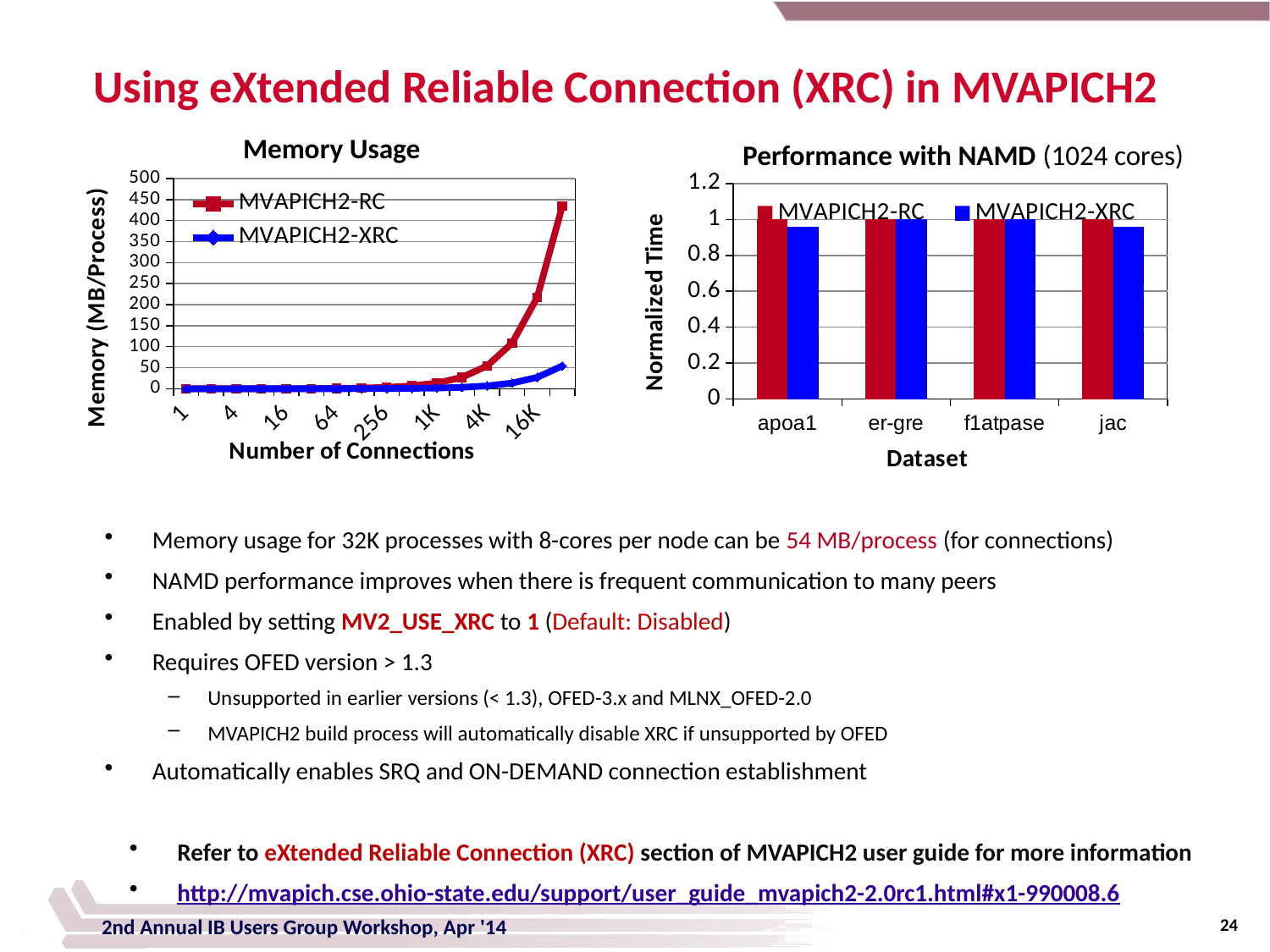
How many series does the legend of the Performance with NAMD chart list? 2 In the Memory Usage chart, which series has the higher memory at 16K connections, MVAPICH2-RC or MVAPICH2-XRC? MVAPICH2-RC What is the x-axis title of the Memory Usage chart? Number of Connections How many series does the legend of the Memory Usage chart list? 2 What is the y-axis title of the Performance with NAMD chart? Normalized Time How many datasets are shown on the x axis of the Performance with NAMD chart? 4 In the Performance with NAMD chart, is the MVAPICH2-XRC value for jac greater or less than 0.8? greater In the Memory Usage chart, which series reaches the highest memory value? MVAPICH2-RC What kind of chart is the Memory Usage chart? line chart In the Performance with NAMD chart, which series has the larger value for apoa1, MVAPICH2-RC or MVAPICH2-XRC? MVAPICH2-RC In the Memory Usage chart, does the MVAPICH2-RC memory rise or fall as the number of connections increases? rise What kind of chart is the Performance with NAMD chart? bar chart